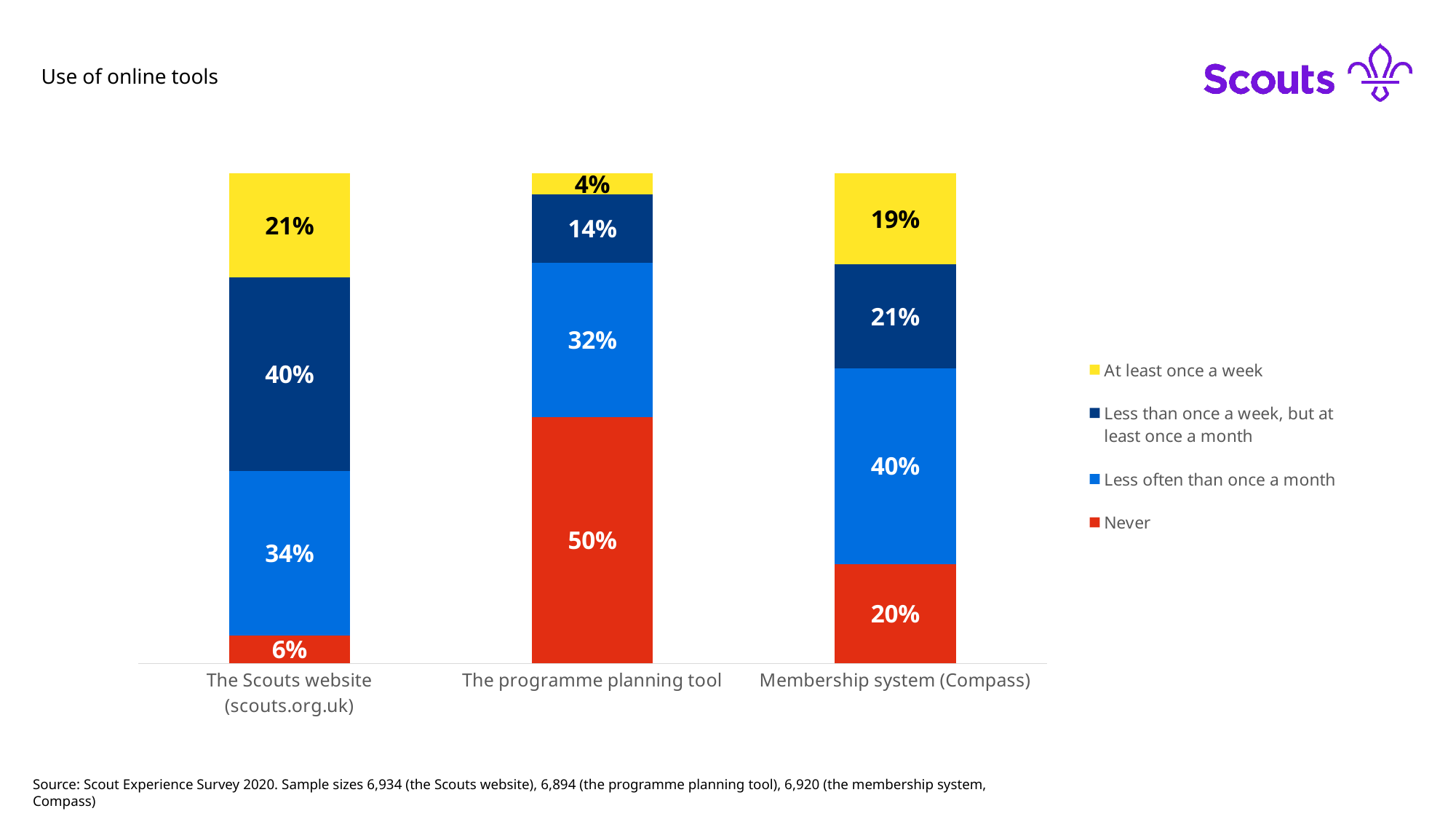
How many online tools are shown on the x axis? 3 What is the difference between the 'Never' share for the programme planning tool and the 'Never' share for the Membership system (Compass)? 30% What kind of chart is shown on the slide? Stacked bar chart Which online tool has the highest share of respondents who never use it? The programme planning tool Which online tool has the lowest share of respondents who never use it? The Scouts website (scouts.org.uk) What percentage of respondents use the programme planning tool at least once a week? 4% How many series does the legend list? 4 What percentage of respondents use the Scouts website (scouts.org.uk) at least once a week? 21% What percentage of respondents use the Membership system (Compass) less often than once a month? 40% Which colour represents 'Never' in the chart? Red Which is larger: the 'At least once a week' share for the Scouts website or for the Membership system (Compass)? The Scouts website (scouts.org.uk) What percentage of respondents never use the programme planning tool? 50%